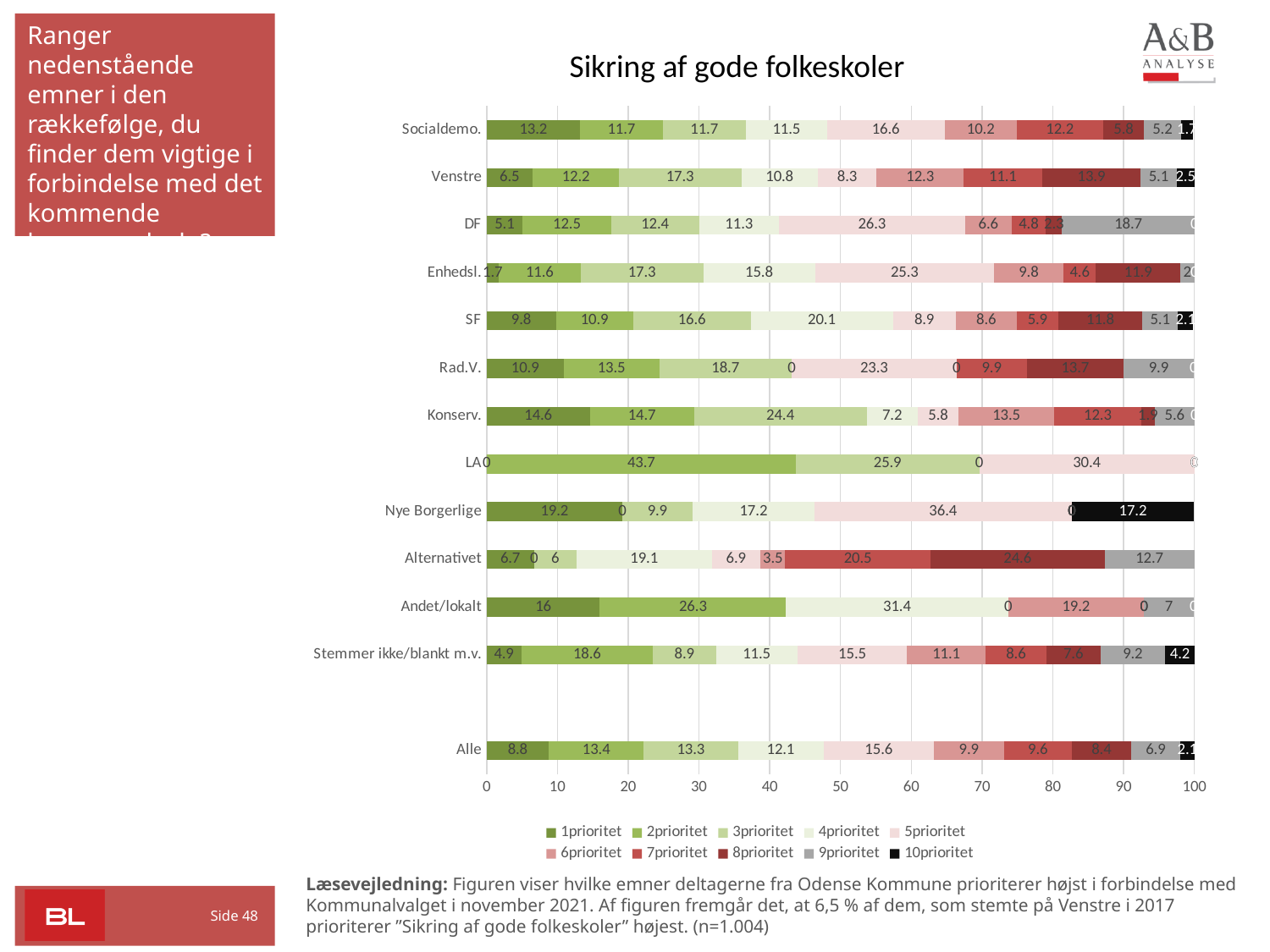
Which category has the highest value for 1prioritet? Nye Borgerlige What is the value of 1prioritet for Venstre? 6.5 Which has the larger 3prioritet value, Venstre or Socialdemo.? Venstre What is the value of 1prioritet for Socialdemo.? 13.2 What is the difference between the 1prioritet values for Konserv. and Socialdemo.? 1.4 How many series does the legend list? 10 How many categories are shown on the y axis? 13 What is the value of 5prioritet for DF? 26.3 What is the value of 2prioritet for LA? 43.7 What kind of chart is shown on the slide? Stacked bar chart What is the value of 1prioritet for Alle? 8.8 What is the value of 10prioritet for Nye Borgerlige? 17.2